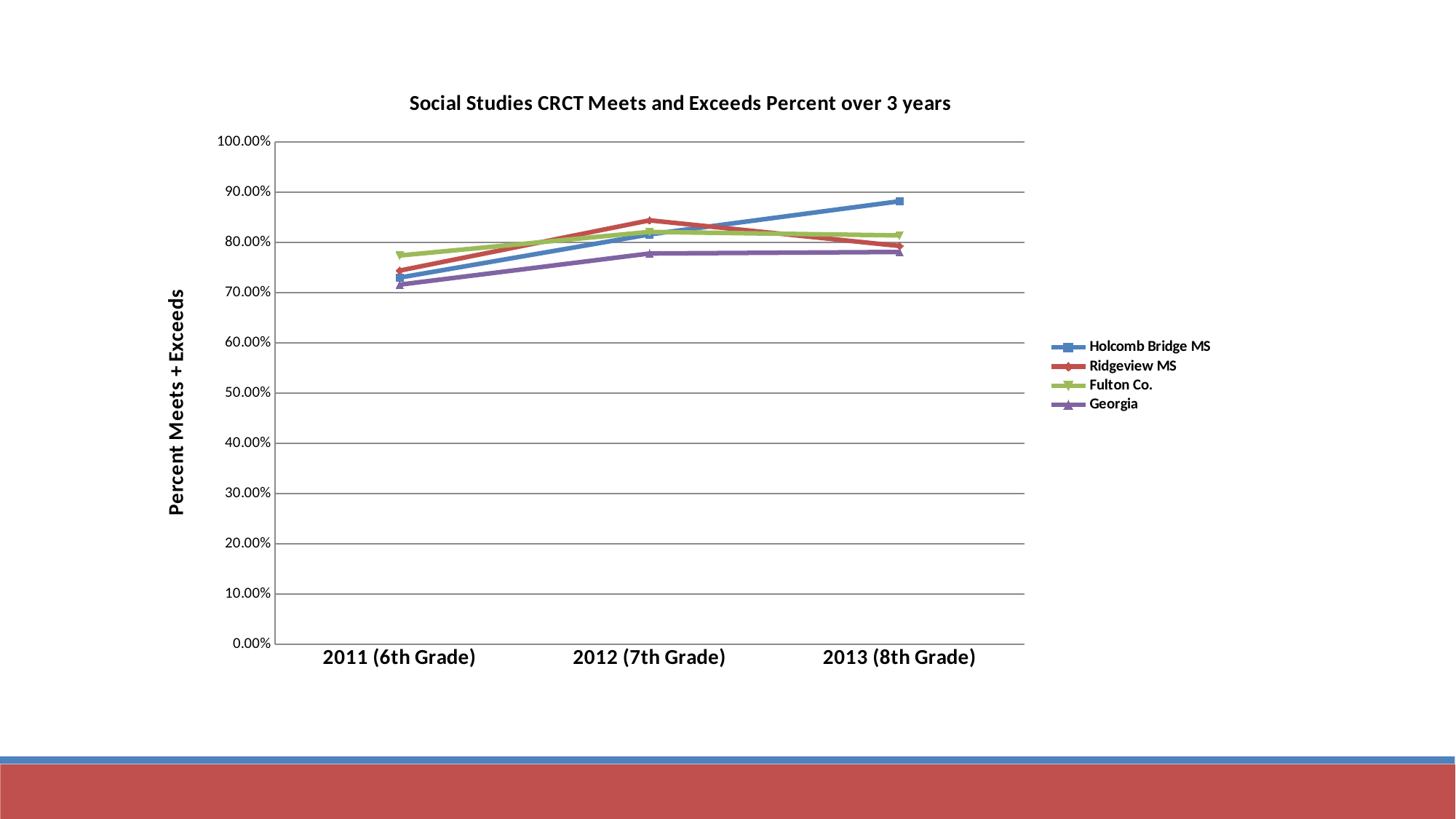
Is the value for Georgia in 2011 (6th Grade) greater or less than 80.00%? less Is the value for Holcomb Bridge MS in 2013 (8th Grade) greater or less than 80.00%? greater What is the title of the chart? Social Studies CRCT Meets and Exceeds Percent over 3 years How many points along the x axis does each line have? 3 Which series has the highest value in 2012 (7th Grade)? Ridgeview MS What kind of chart is shown on the slide? line chart In 2013 (8th Grade), which is larger: Holcomb Bridge MS or Georgia? Holcomb Bridge MS Does the Holcomb Bridge MS line rise or fall from 2011 (6th Grade) to 2013 (8th Grade)? rise Which series has the highest value in 2013 (8th Grade)? Holcomb Bridge MS How many series does the legend list? 4 Which series has the highest value in 2011 (6th Grade)? Fulton Co. Is the value for Ridgeview MS in 2012 (7th Grade) greater or less than 80.00%? greater